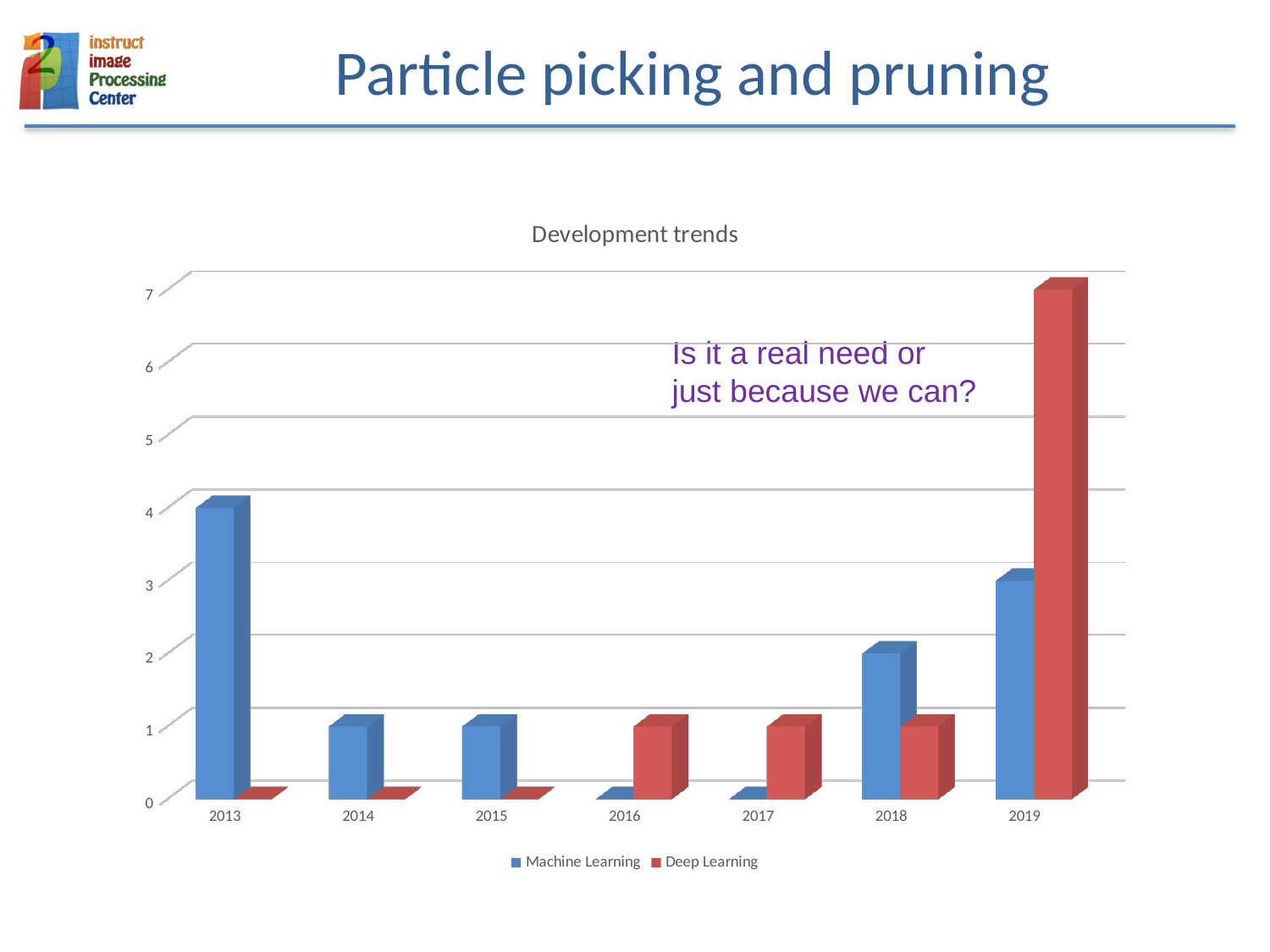
How many series does the legend list? 2 How many years are shown on the x axis? 7 Which year has the highest Machine Learning value? 2013 What is the title of the chart? Development trends What is the Deep Learning value for 2019? 7 Which year has the highest Deep Learning value? 2019 In 2018, which series has the larger value, Machine Learning or Deep Learning? Machine Learning Is the Deep Learning value for 2019 greater or less than 6? greater In 2019, which series has the larger value, Machine Learning or Deep Learning? Deep Learning Which colour represents the Deep Learning series? red What is the Machine Learning value for 2013? 4 What kind of chart is shown on the slide? bar chart